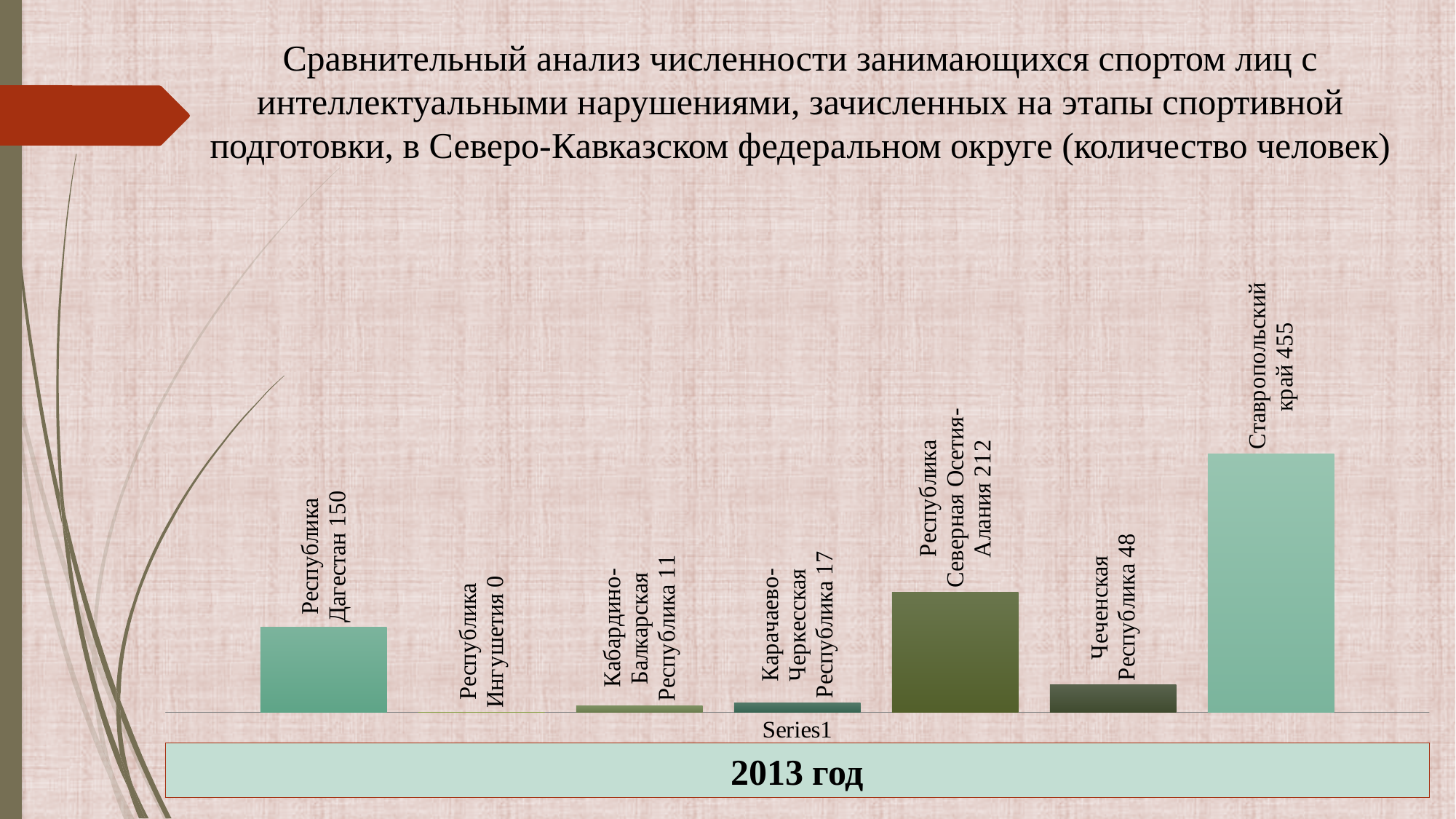
What is the value for Республика Северная Осетия-Алания? 212 How many regions are shown in the chart? 7 What is the difference between the values for Карачаево-Черкесская Республика and Кабардино-Балкарская Республика? 6 Which region has the lowest value? Республика Ингушетия What year is shown below the chart? 2013 год Which is larger, the value for Республика Дагестан or the value for Чеченская Республика? Республика Дагестан What type of chart is shown on the slide? bar chart What is the value for Республика Дагестан? 150 Which region has the highest value? Ставропольский край What is the difference between the values for Ставропольский край and Республика Северная Осетия-Алания? 243 What is the value for Ставропольский край? 455 What is the value for Чеченская Республика? 48